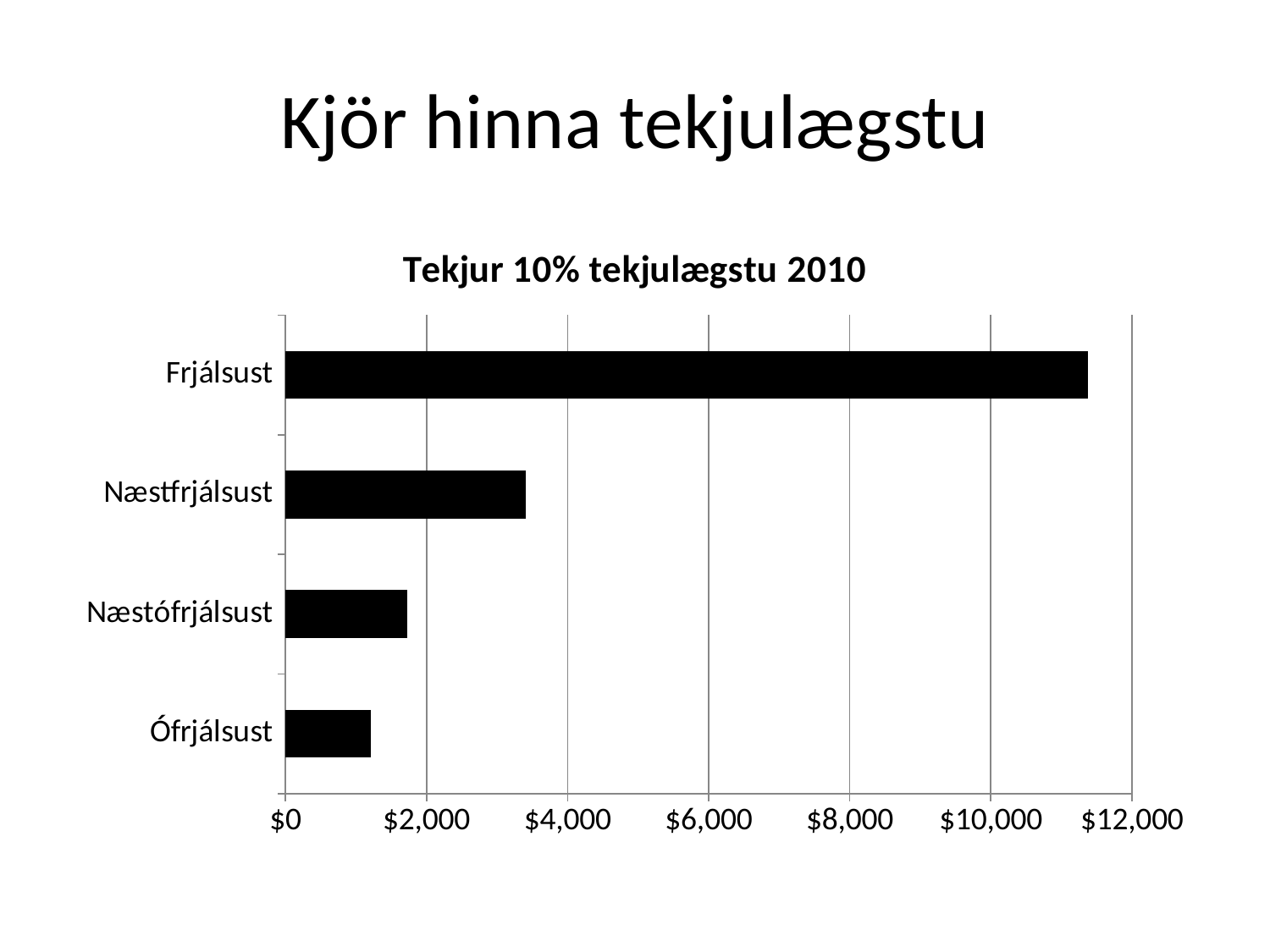
What type of chart is shown on the slide? bar chart Is the value for Næstfrjálsust greater or less than $4,000? less What is the title of the chart? Tekjur 10% tekjulægstu 2010 Which has a larger value, Næstfrjálsust or Næstófrjálsust? Næstfrjálsust Which category has the lowest value? Ófrjálsust Is the value for Ófrjálsust greater or less than $2,000? less Is the value for Frjálsust greater or less than $10,000? greater Which has a larger value, Ófrjálsust or Frjálsust? Frjálsust How many categories are shown in the chart? 4 Which category has the highest value? Frjálsust What is the maximum value shown on the horizontal axis? $12,000